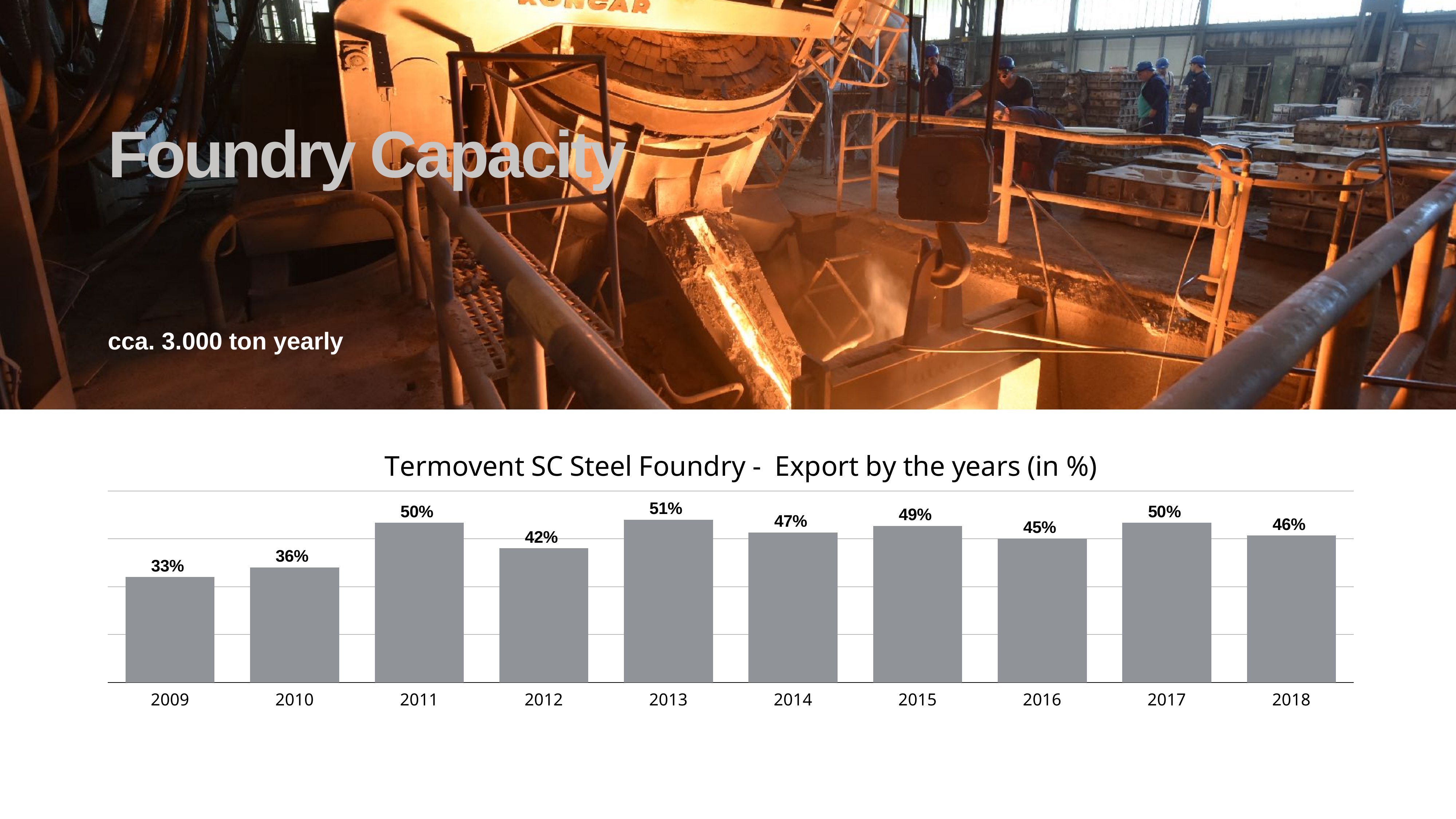
What is the export value for 2013? 51% Which year has the highest export percentage? 2013 What kind of chart is shown on the slide? Bar chart What is the export value for 2009? 33% What is the difference between the export values for 2018 and 2009? 13% What is the export value for 2016? 45% What is the difference between the export values for 2011 and 2012? 8% Which is larger, the export value for 2014 or for 2016? 2014 Do the export values rise or fall from 2009 to 2011? Rise Which year has the lowest export percentage? 2009 How many years are shown on the chart? 10 What is the title of the chart? Termovent SC Steel Foundry - Export by the years (in %)